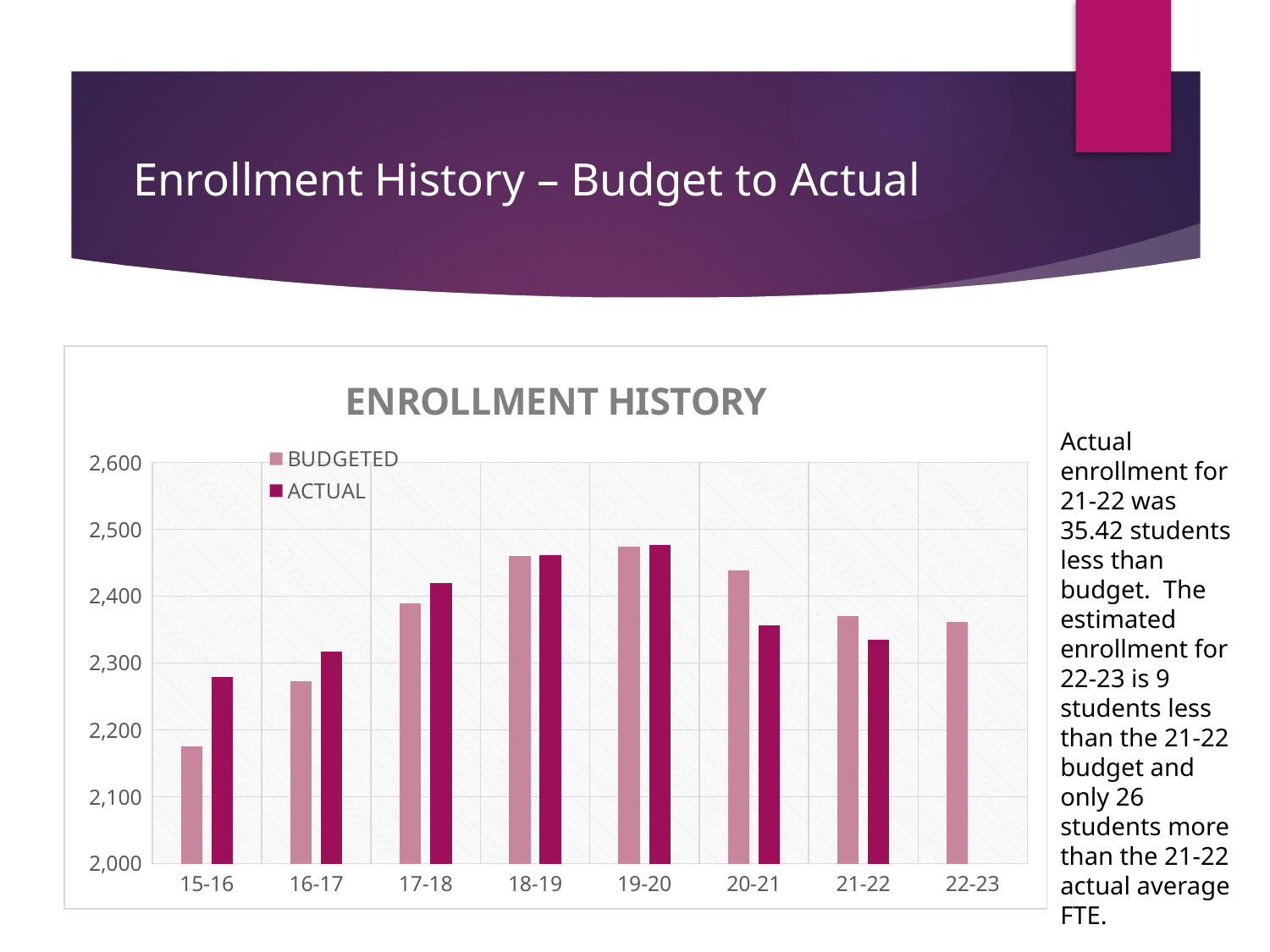
How many school-year categories are shown on the x axis? 8 Is the BUDGETED value for 15-16 greater or less than 2,200? less How many series does the chart legend list? 2 Which year has the lowest ACTUAL enrollment? 15-16 Is the ACTUAL value for 20-21 greater or less than 2,400? less For 21-22, which is larger, the BUDGETED or the ACTUAL enrollment? BUDGETED Which year has the lowest BUDGETED enrollment? 15-16 For 15-16, which is larger, the BUDGETED or the ACTUAL enrollment? ACTUAL Is the BUDGETED value for 20-21 greater or less than 2,400? greater What type of chart is shown on the slide? Bar chart What is the title of the chart? ENROLLMENT HISTORY Which category has no ACTUAL bar? 22-23